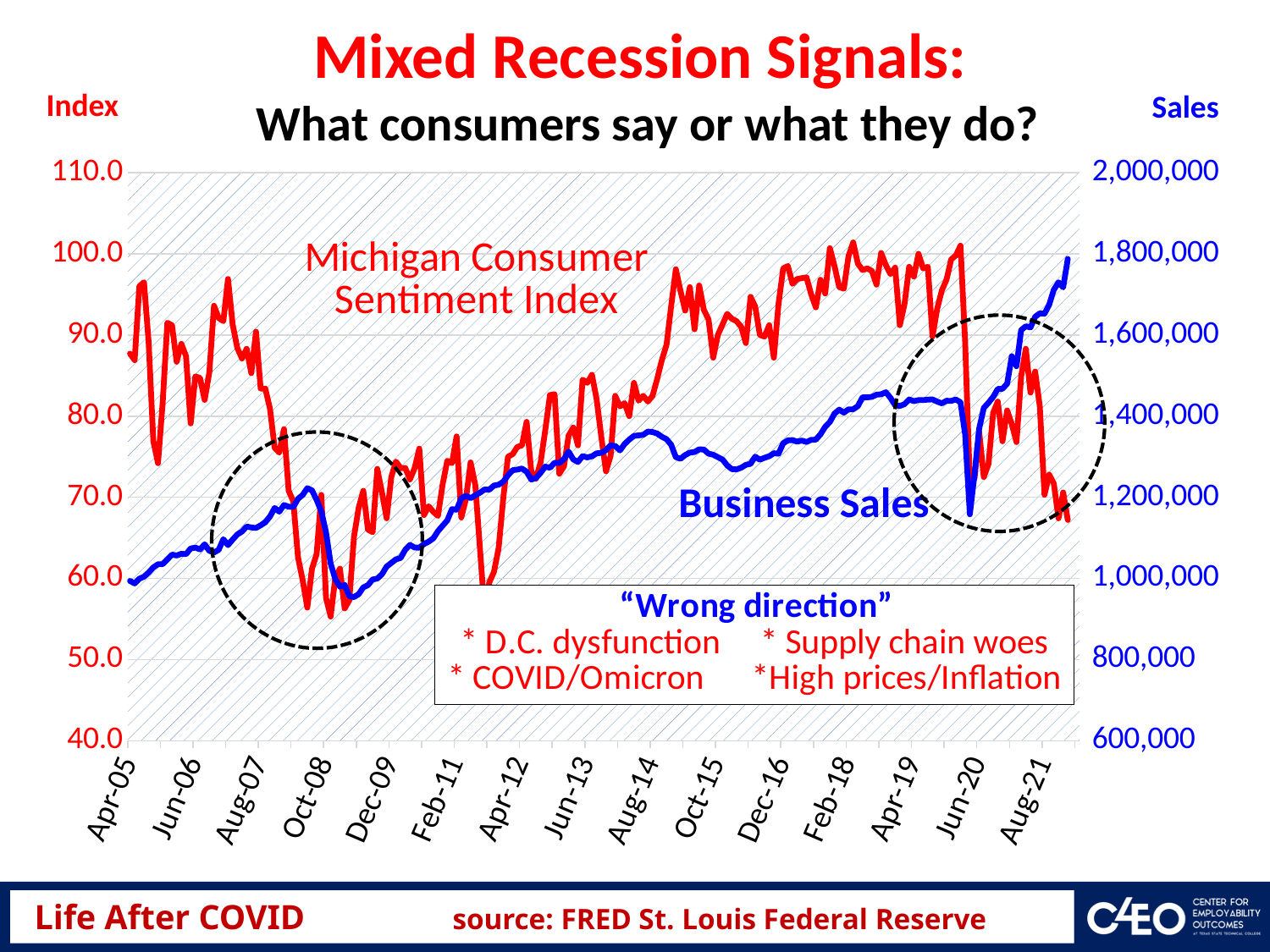
How many data series are plotted on the chart? 2 Is the Michigan Consumer Sentiment Index value at Apr-05 greater or less than 80.0? greater What is the label of the right-hand vertical axis? Sales Is the Business Sales value at the end of the series (after Aug-21) greater or less than 1,600,000? greater Which series is plotted in red? Michigan Consumer Sentiment Index Is the Business Sales value around Jun-20 greater or less than 1,400,000? less Does Business Sales generally rise or fall from Apr-05 to Aug-21? Rise How many date labels are shown along the x axis? 15 Does the Michigan Consumer Sentiment Index generally rise or fall between Apr-12 and Feb-18? Rise What kind of chart is shown on the slide? Line chart